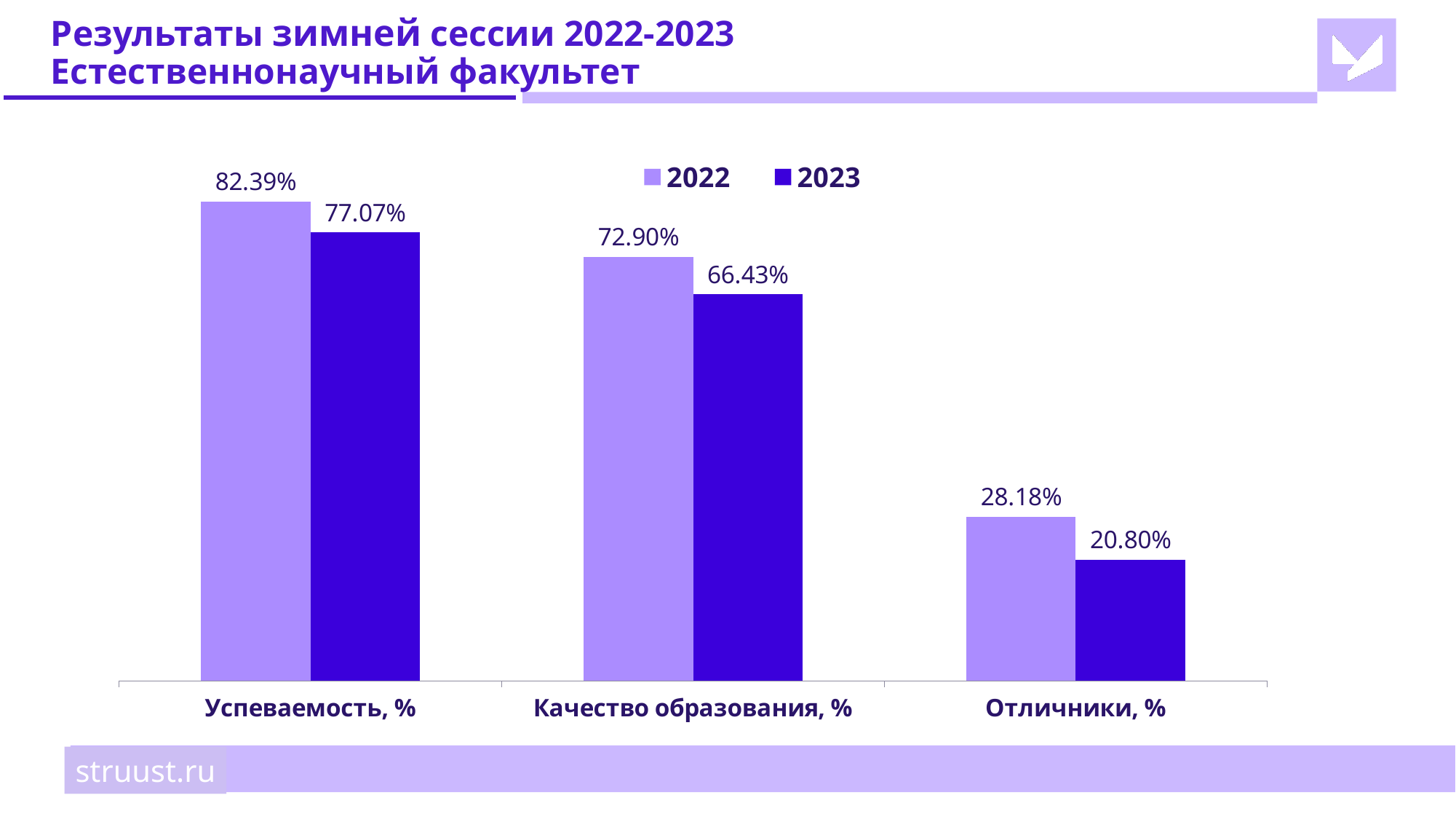
What is the difference between the 2022 and 2023 values for Отличники, %? 7.38% How many series does the legend list? 2 Which is larger for Качество образования, %: the 2022 value or the 2023 value? 2022 What is the difference between the 2022 and 2023 values for Успеваемость, %? 5.32% What is the value for 2023 in the Отличники, % category? 20.80% What is the value for 2023 in the Качество образования, % category? 66.43% What kind of chart is shown on the slide? Bar chart Which category has the highest value for 2022? Успеваемость, % Which category has the lowest value for 2023? Отличники, % How many categories are shown on the x axis? 3 What is the value for 2022 in the Качество образования, % category? 72.90% What is the value for 2022 in the Успеваемость, % category? 82.39%